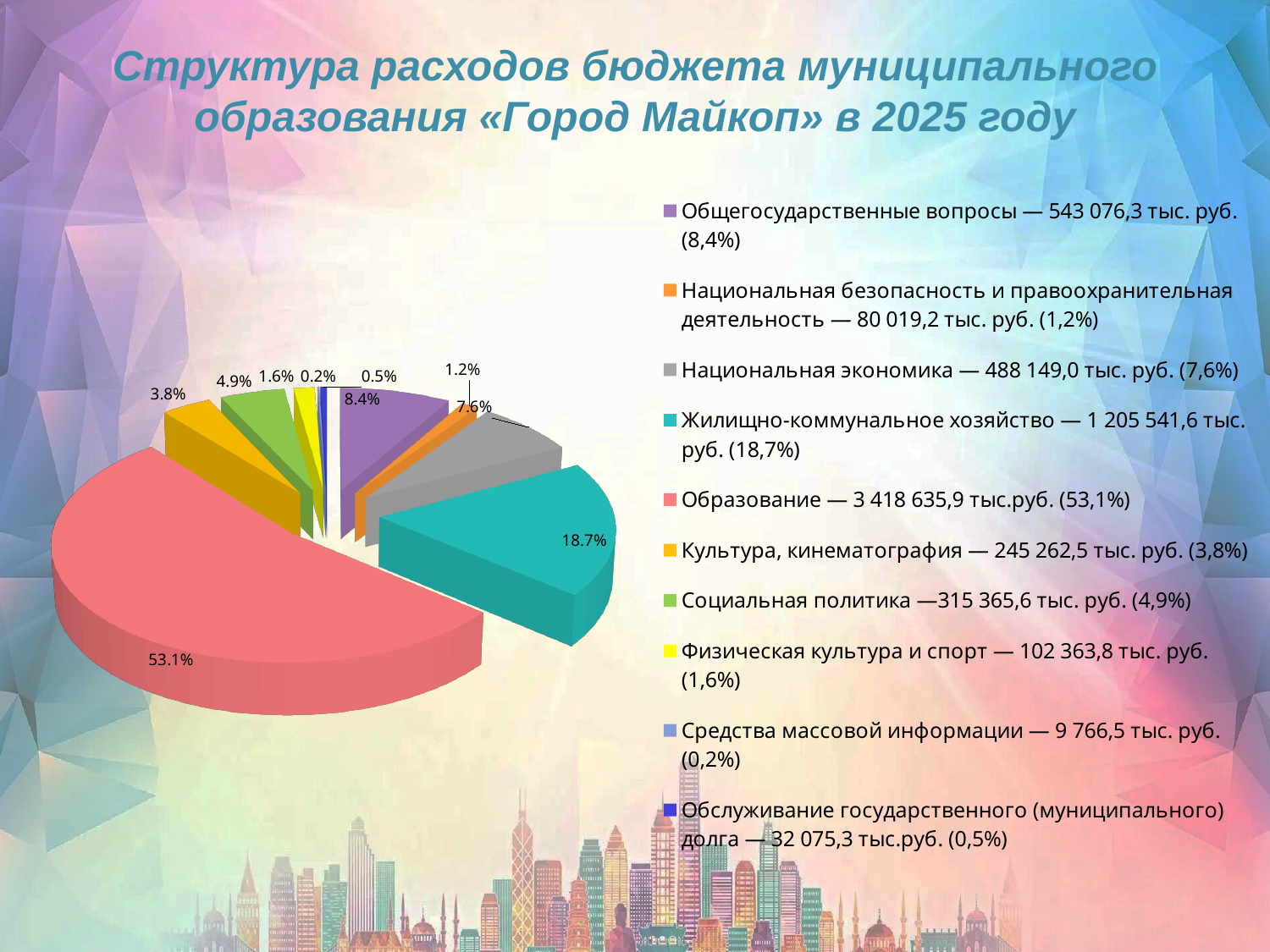
How many categories (slices) does the pie chart have? 10 What is the amount shown in the legend for Социальная политика? 315 365,6 тыс. руб. How many entries does the legend list? 10 What is the difference in percentage points between the Образование slice (53.1%) and the Жилищно-коммунальное хозяйство slice (18.7%)? 34.4 What kind of chart is shown on the slide? pie chart What share of the pie does Образование (education) take? 53.1% Which category has the smallest slice of the pie? Средства массовой информации What is the amount shown in the legend for Национальная экономика? 488 149,0 тыс. руб. Which is larger: the share for Общегосударственные вопросы or the share for Национальная экономика? Общегосударственные вопросы What colour is the slice for Образование? red (pink-red) What share of the pie does Жилищно-коммунальное хозяйство take? 18.7% Which category has the largest slice of the pie? Образование